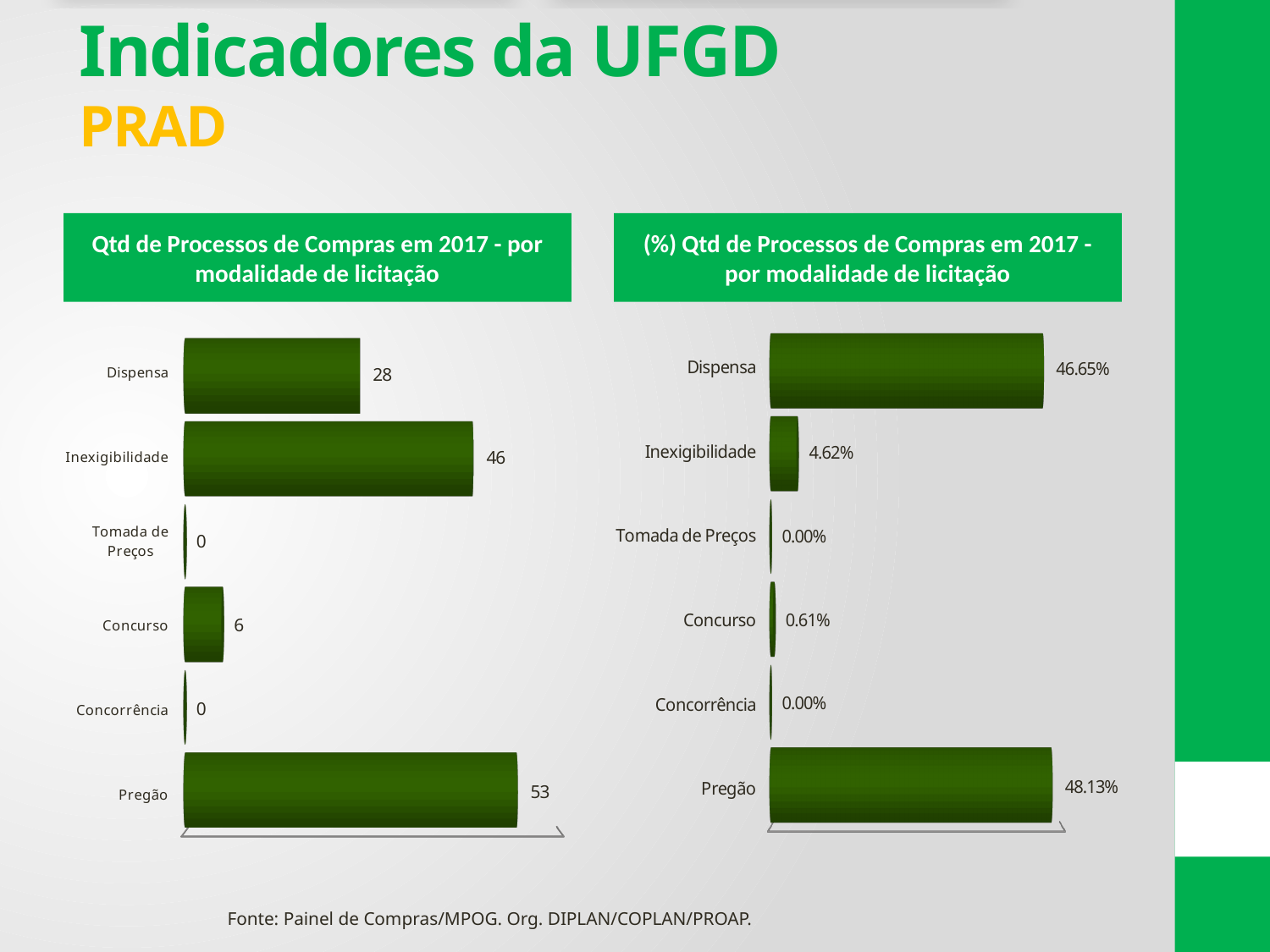
In the right chart ((%) Qtd de Processos de Compras em 2017 - por modalidade de licitação), what is the value for Inexigibilidade? 4.62% What type of chart is the left chart (Qtd de Processos de Compras em 2017 - por modalidade de licitação)? Bar chart In the left chart (Qtd de Processos de Compras em 2017 - por modalidade de licitação), what is the difference between Pregão and Dispensa? 25 In the left chart (Qtd de Processos de Compras em 2017 - por modalidade de licitação), which is larger, Dispensa or Inexigibilidade? Inexigibilidade In the right chart ((%) Qtd de Processos de Compras em 2017 - por modalidade de licitação), which category has the highest value? Pregão In the right chart ((%) Qtd de Processos de Compras em 2017 - por modalidade de licitação), what is the value for Concurso? 0.61% In the right chart ((%) Qtd de Processos de Compras em 2017 - por modalidade de licitação), what is the value for Dispensa? 46.65% In the left chart (Qtd de Processos de Compras em 2017 - por modalidade de licitação), how many categories are shown? 6 In the left chart (Qtd de Processos de Compras em 2017 - por modalidade de licitação), what is the value for Inexigibilidade? 46 In the left chart (Qtd de Processos de Compras em 2017 - por modalidade de licitação), what is the value for Concurso? 6 In the left chart (Qtd de Processos de Compras em 2017 - por modalidade de licitação), which category has the highest value? Pregão In the right chart ((%) Qtd de Processos de Compras em 2017 - por modalidade de licitação), what is the difference between Pregão and Dispensa? 1.48%